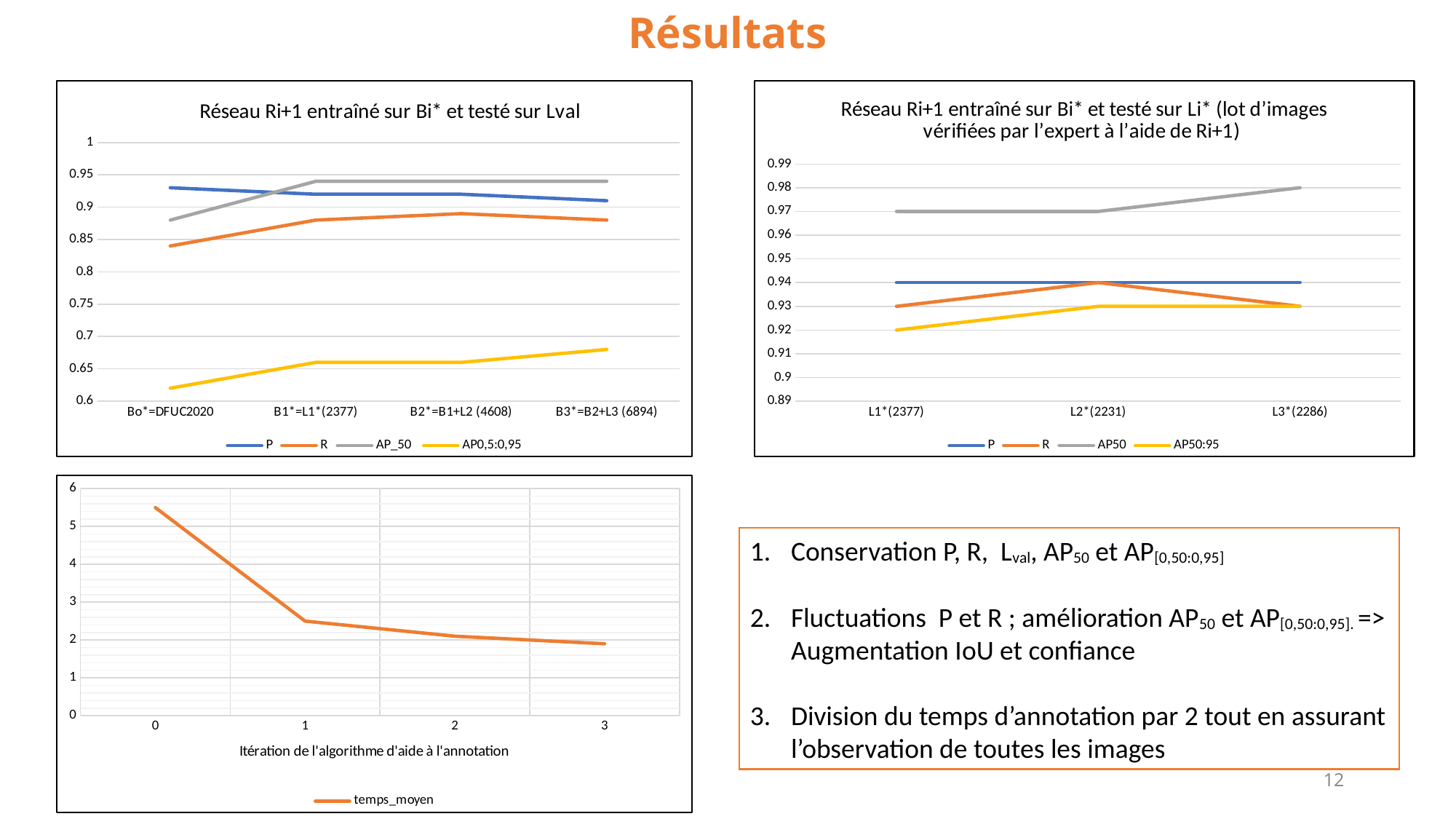
In the bottom-left chart, is the value of temps_moyen at iteration 0 greater or less than 5? greater In the bottom-left chart, do the values of temps_moyen rise or fall as the iteration increases? fall In the chart titled "Réseau Ri+1 entraîné sur Bi* et testé sur Li*", what is the value of AP50 at L3*(2286)? 0.98 In the chart titled "Réseau Ri+1 entraîné sur Bi* et testé sur Li*", what is the value of P at L1*(2377)? 0.94 In the chart titled "Réseau Ri+1 entraîné sur Bi* et testé sur Lval", how many categories are on the x axis? 4 In the chart titled "Réseau Ri+1 entraîné sur Bi* et testé sur Lval", which series has the lowest values across all categories? AP0,5:0,95 In the chart titled "Réseau Ri+1 entraîné sur Bi* et testé sur Li*", does the AP50 series rise or fall from L2*(2231) to L3*(2286)? rise In the chart titled "Réseau Ri+1 entraîné sur Bi* et testé sur Li*", which series has the highest values at every category? AP50 In the chart titled "Réseau Ri+1 entraîné sur Bi* et testé sur Lval", how many series does the legend list? 4 What kind of chart is the chart titled "Réseau Ri+1 entraîné sur Bi* et testé sur Lval"? line chart In the chart titled "Réseau Ri+1 entraîné sur Bi* et testé sur Lval", is the value of AP0,5:0,95 at Bo*=DFUC2020 greater or less than 0.65? less What is the x-axis title of the bottom-left chart? Itération de l'algorithme d'aide à l'annotation